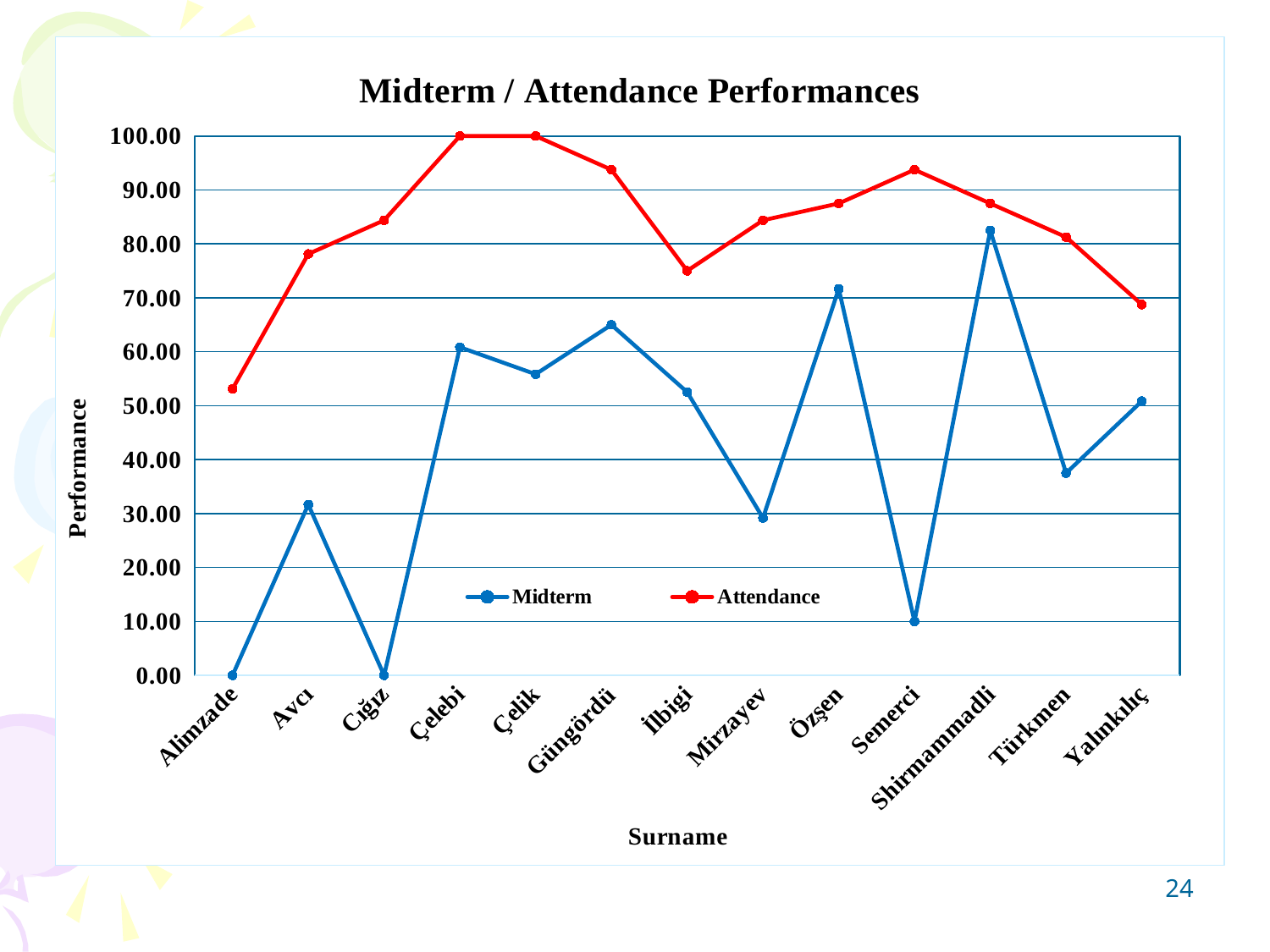
What is the Attendance value for Çelebi? 100.00 Which surname has the highest Midterm value? Shirmammadli What is the Midterm value for Cığız? 0.00 How many series does the legend list? 2 Is the Midterm value for Türkmen greater or less than 40.00? less Which surname has the lowest Attendance value? Alimzade Is the Attendance value for İlbigi greater or less than 70.00? greater What kind of chart is shown on the slide? Line chart What is the title of the chart? Midterm / Attendance Performances How many surnames are plotted along the x axis? 13 Which is larger, the Midterm value for Özşen or the Midterm value for Shirmammadli? Shirmammadli What is the Midterm value for Alimzade? 0.00